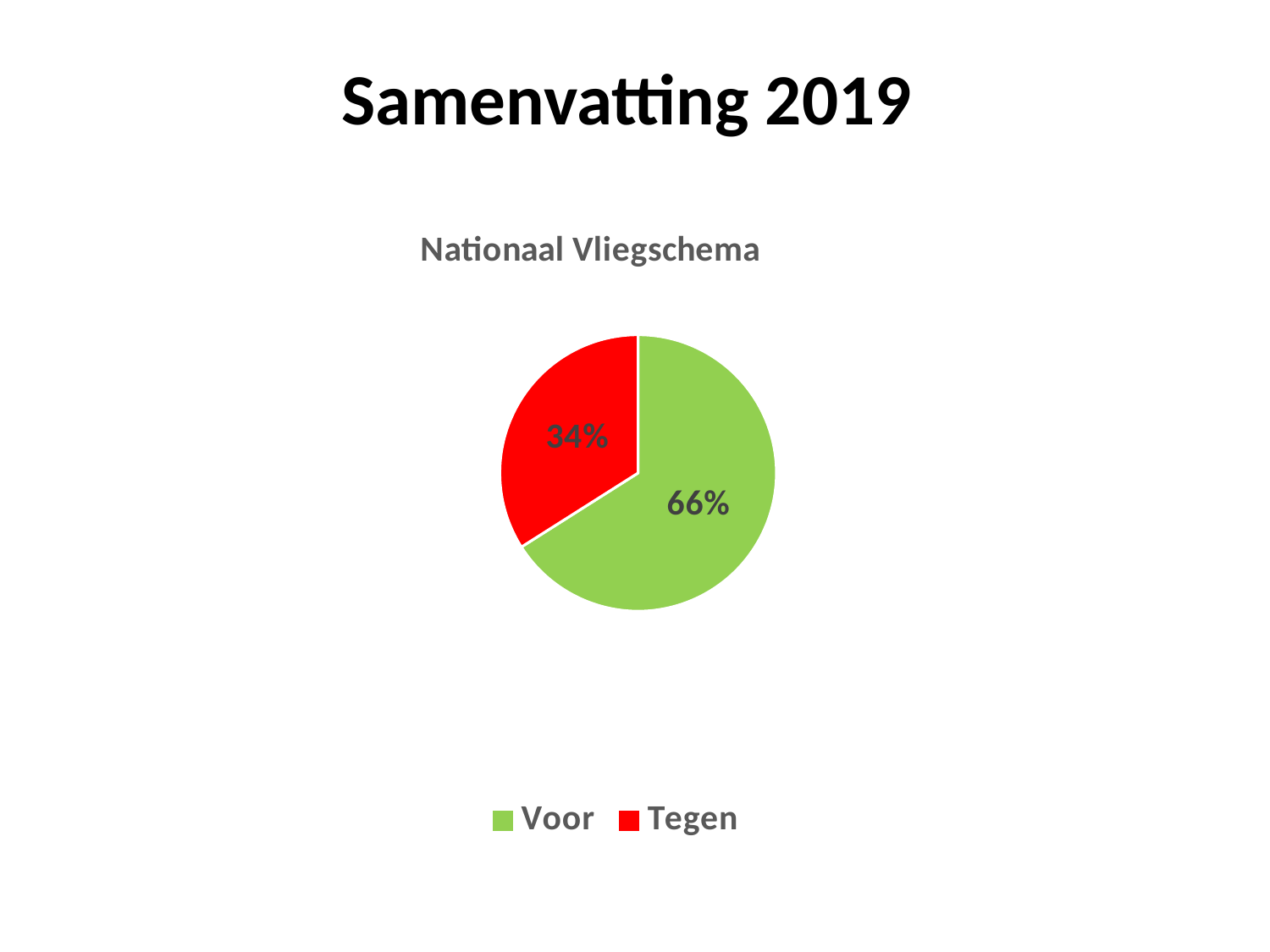
What is the title of the chart? Nationaal Vliegschema What kind of chart is shown on the slide? Pie chart How many entries does the legend list? 2 What colour is the Tegen slice? Red Which category has the smallest slice of the pie? Tegen How many slices does the pie chart have? 2 What is the difference in percentage points between Voor and Tegen? 32 What share of the pie does Tegen represent? 34% What share of the pie does Voor represent? 66% Which is larger, the share for Voor or the share for Tegen? Voor Which category has the largest slice of the pie? Voor